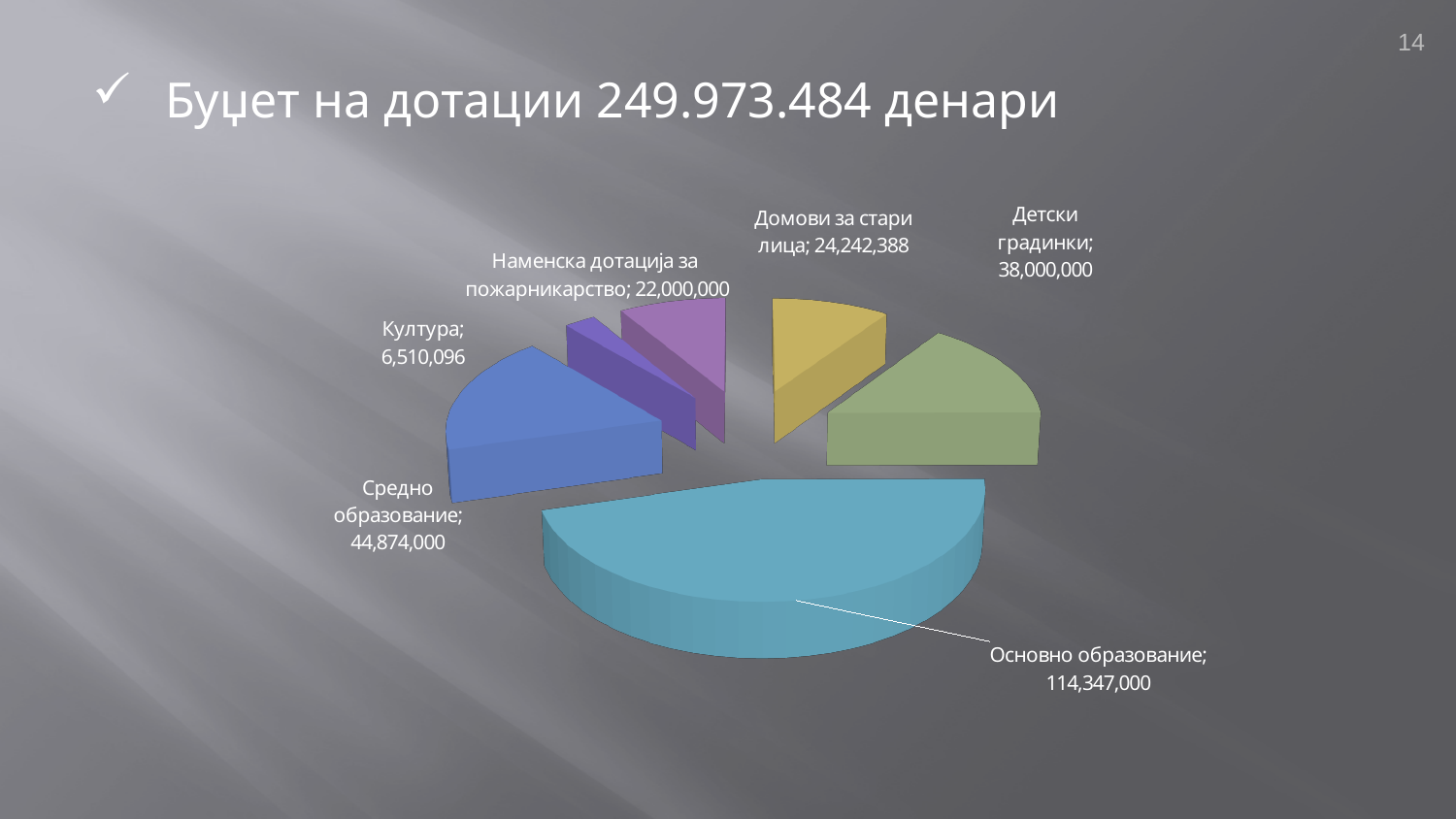
What is the value for Средно образование? 44,874,000 Which is larger, the value for Детски градинки or the value for Наменска дотација за пожарникарство? Детски градинки What kind of chart is shown on the slide? Pie chart What is the value for Култура? 6,510,096 How many slices does the pie chart have? 6 What is the difference between the values for Детски градинки and Домови за стари лица? 13,757,612 What is the title shown above the chart? Буџет на дотации 249.973.484 денари What is the value for Основно образование? 114,347,000 What is the value for Домови за стари лица? 24,242,388 Which category has the smallest slice of the pie? Култура What is the difference between the values for Основно образование and Средно образование? 69,473,000 Which category has the largest slice of the pie? Основно образование